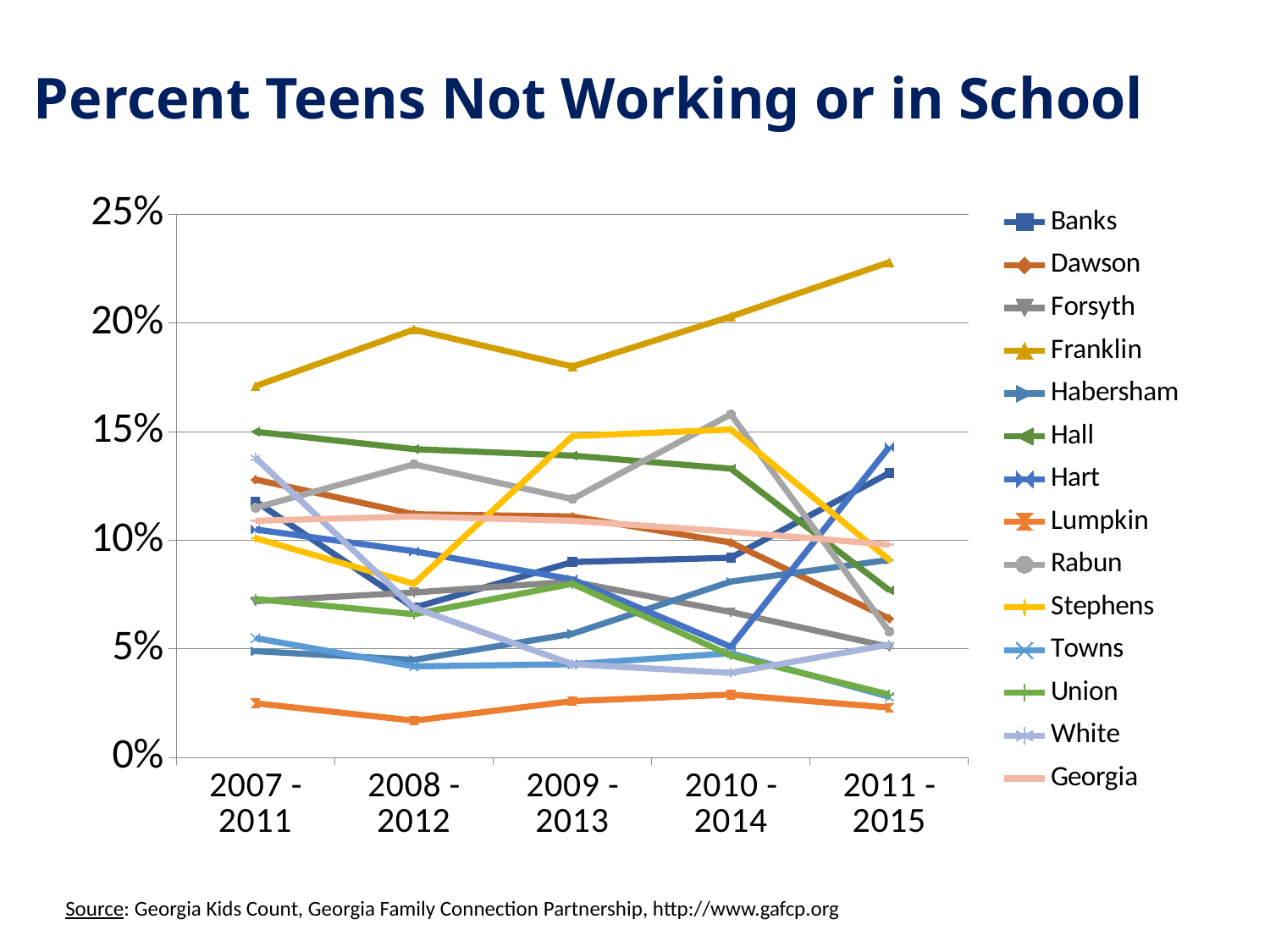
How many series does the legend list? 14 Which county has the highest percent of teens not working or in school in 2011 - 2015? Franklin What kind of chart is shown on the slide? line chart Is the value for Lumpkin in 2008 - 2012 greater or less than 5%? less Does the value for Franklin rise or fall overall from 2007 - 2011 to 2011 - 2015? rise Is the value for Rabun in 2010 - 2014 greater or less than 15%? greater Which is larger in 2009 - 2013, the value for Stephens or the value for Lumpkin? Stephens Does the value for Hall rise or fall from 2007 - 2011 to 2011 - 2015? fall How many time periods are shown along the x axis? 5 Is the value for Franklin in 2011 - 2015 greater or less than 20%? greater What is the title of the chart? Percent Teens Not Working or in School Which county has the lowest percent of teens not working or in school in 2008 - 2012? Lumpkin